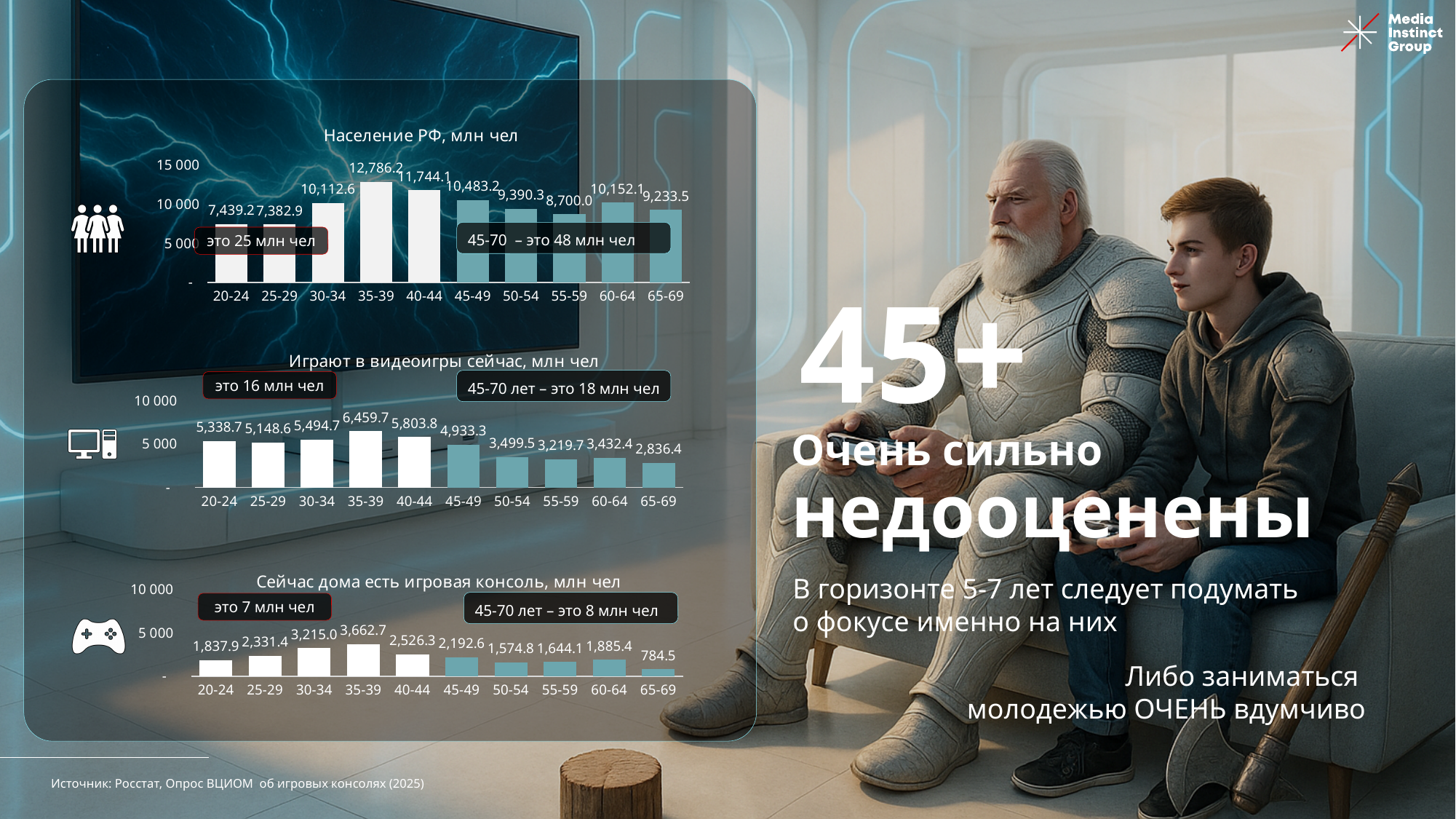
In the chart 'Население РФ, млн чел', which age group has the lowest value? 25-29 In the chart 'Население РФ, млн чел', what is the value for the 35-39 age group? 12,786.2 In the chart 'Играют в видеоигры сейчас, млн чел', which age group has the highest value? 35-39 In the chart 'Играют в видеоигры сейчас, млн чел', what is the value for the 45-49 age group? 4,933.3 In the chart 'Население РФ, млн чел', what is the difference between the values for 40-44 and 45-49? 1,260.9 How many age groups are shown on the x axis of the chart 'Население РФ, млн чел'? 10 In the chart 'Играют в видеоигры сейчас, млн чел', which is larger: the value for 50-54 or for 60-64? 50-54 In the chart 'Сейчас дома есть игровая консоль, млн чел', what is the value for the 65-69 age group? 784.5 In the chart 'Сейчас дома есть игровая консоль, млн чел', which age group has the highest value? 35-39 In the chart 'Сейчас дома есть игровая консоль, млн чел', what is the difference between the values for 30-34 and 20-24? 1,377.1 What type of chart is 'Играют в видеоигры сейчас, млн чел'? Bar chart In the chart 'Сейчас дома есть игровая консоль, млн чел', is the value for 35-39 greater or less than 5 000? less